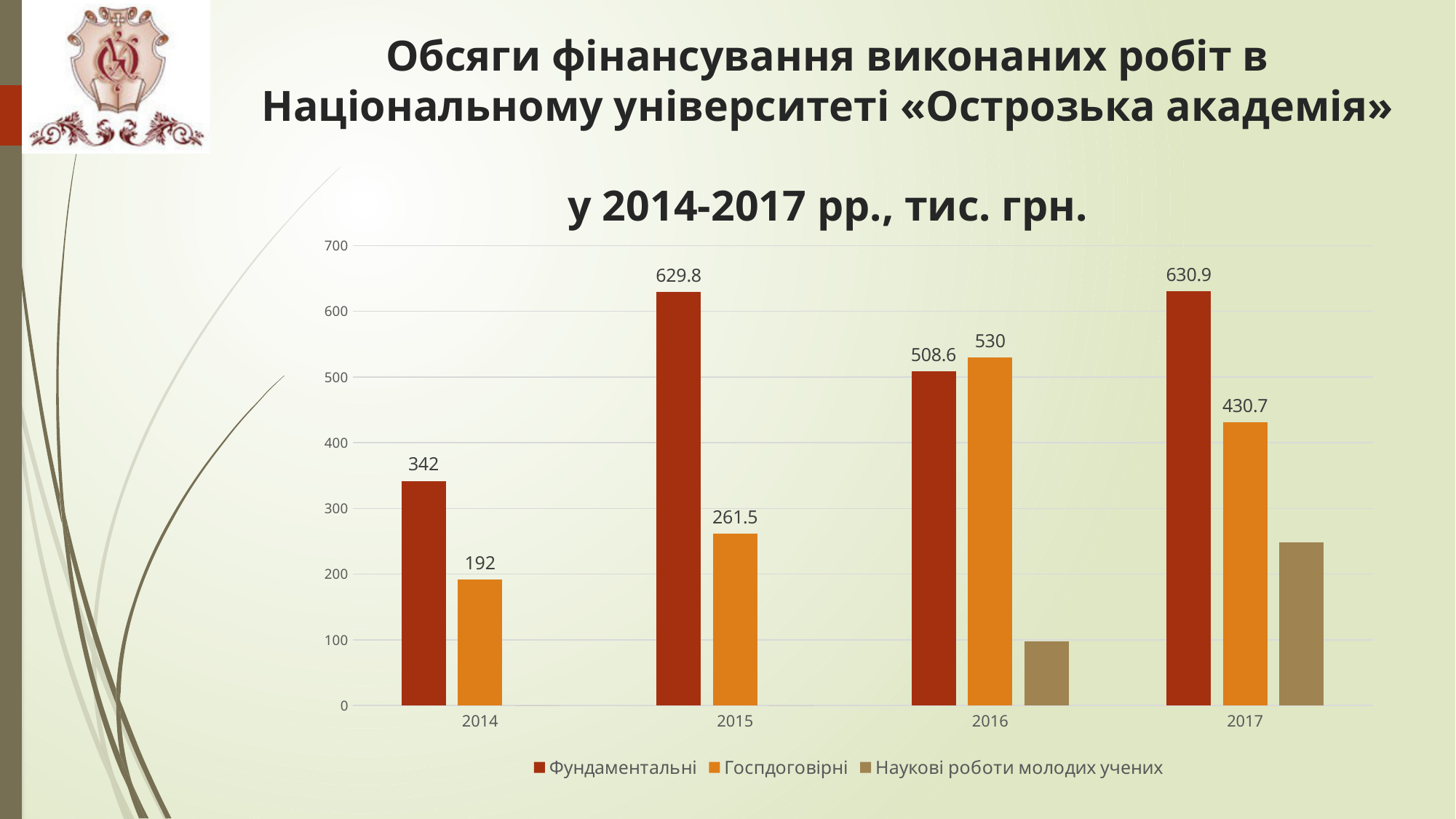
What is the value for Госпдоговірні in 2016? 530 What is the value for Госпдоговірні in 2017? 430.7 What is the difference between Фундаментальні and Госпдоговірні in 2015? 368.3 What is the difference between Фундаментальні and Госпдоговірні in 2014? 150 What is the value for Фундаментальні in 2014? 342 What is the value for Фундаментальні in 2015? 629.8 How many years are shown on the x axis? 4 How many series does the legend list? 3 Is the value for Наукові роботи молодих учених in 2017 greater or less than 200? greater In which year is the value for Госпдоговірні the lowest? 2014 Is the value for Наукові роботи молодих учених in 2016 greater or less than 200? less In 2016, which is larger: Фундаментальні or Госпдоговірні? Госпдоговірні